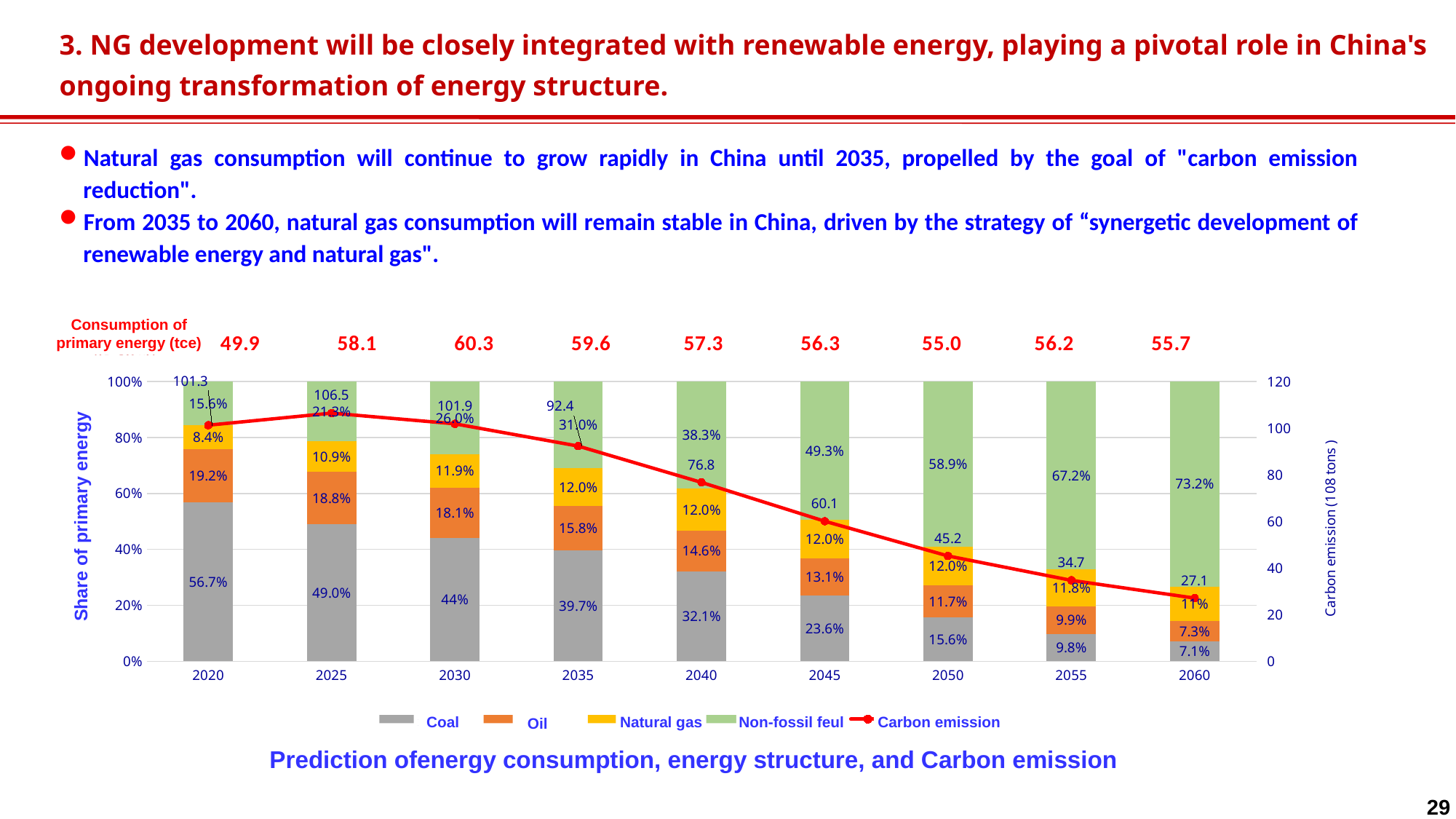
What is the carbon emission value shown for 2025? 106.5 What is the difference between the carbon emission values for 2020 and 2060? 74.2 What is the share of coal in primary energy in 2020? 56.7% What is the share of non-fossil fuel in 2060? 73.2% How does the carbon emission line change from 2025 to 2060? It falls In which year is the share of coal lowest? 2060 Which is larger in 2050: the share of oil or the share of natural gas? Natural gas What is the share of natural gas in 2035? 12.0% What is the title shown below the chart? Prediction ofenergy consumption, energy structure, and Carbon emission How many years are shown on the x axis of the chart? 9 How many series does the chart legend list? 5 In which year is the carbon emission value highest? 2025